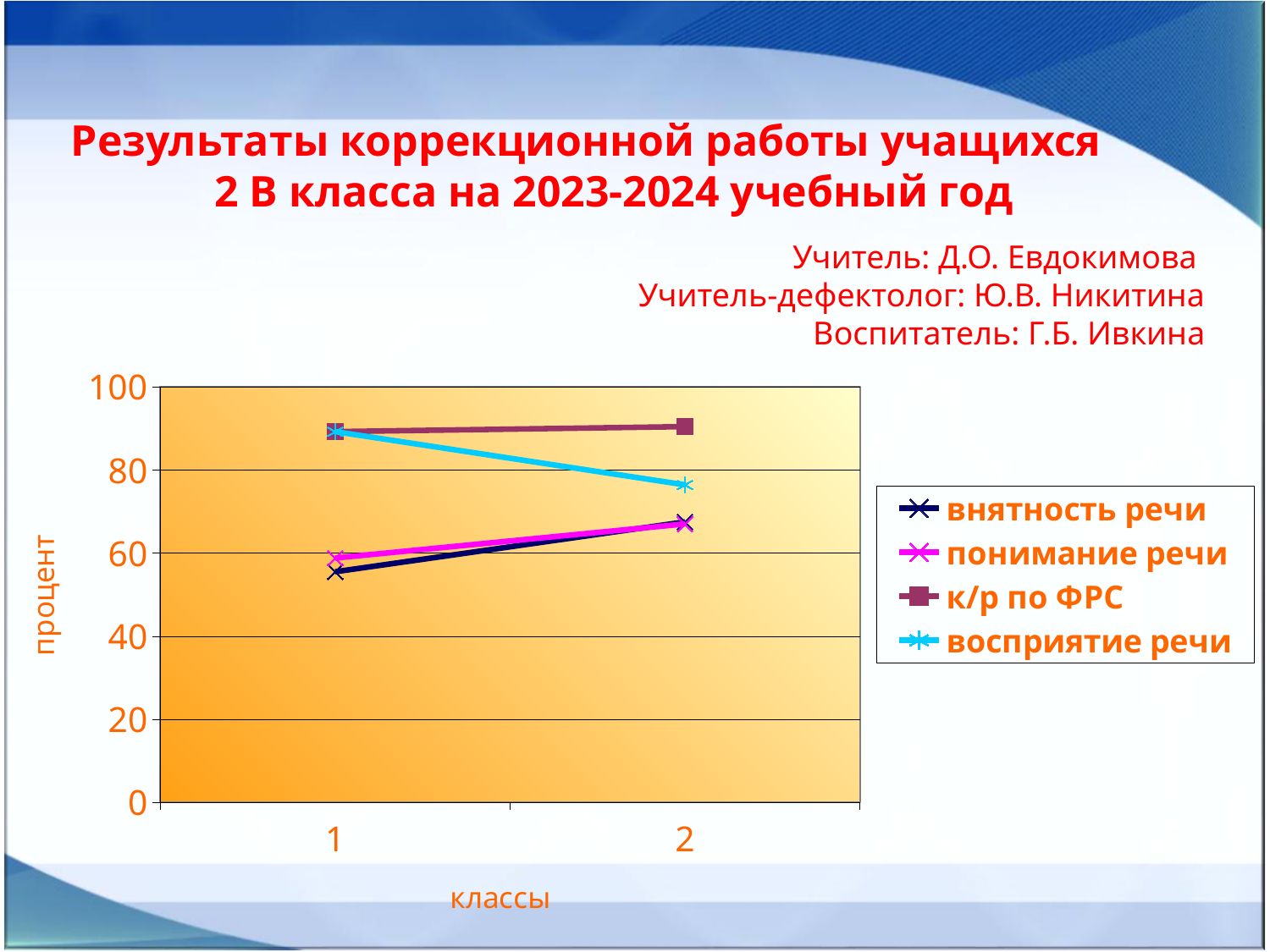
Does the value for "понимание речи" rise or fall from class 1 to class 2? rise At class 2, which is larger: the value for "восприятие речи" or the value for "понимание речи"? восприятие речи What is the title of the vertical axis? процент What kind of chart is shown on the slide? line chart How many categories are shown on the x axis? 2 Is the value for "восприятие речи" at class 2 greater or less than 80? less Is the value for "внятность речи" at class 1 greater or less than 60? less Which series has the highest value at class 2? к/р по ФРС How many series does the legend list? 4 Does the value for "внятность речи" rise or fall from class 1 to class 2? rise Is the value for "к/р по ФРС" at class 2 greater or less than 80? greater Does the value for "восприятие речи" rise or fall from class 1 to class 2? fall